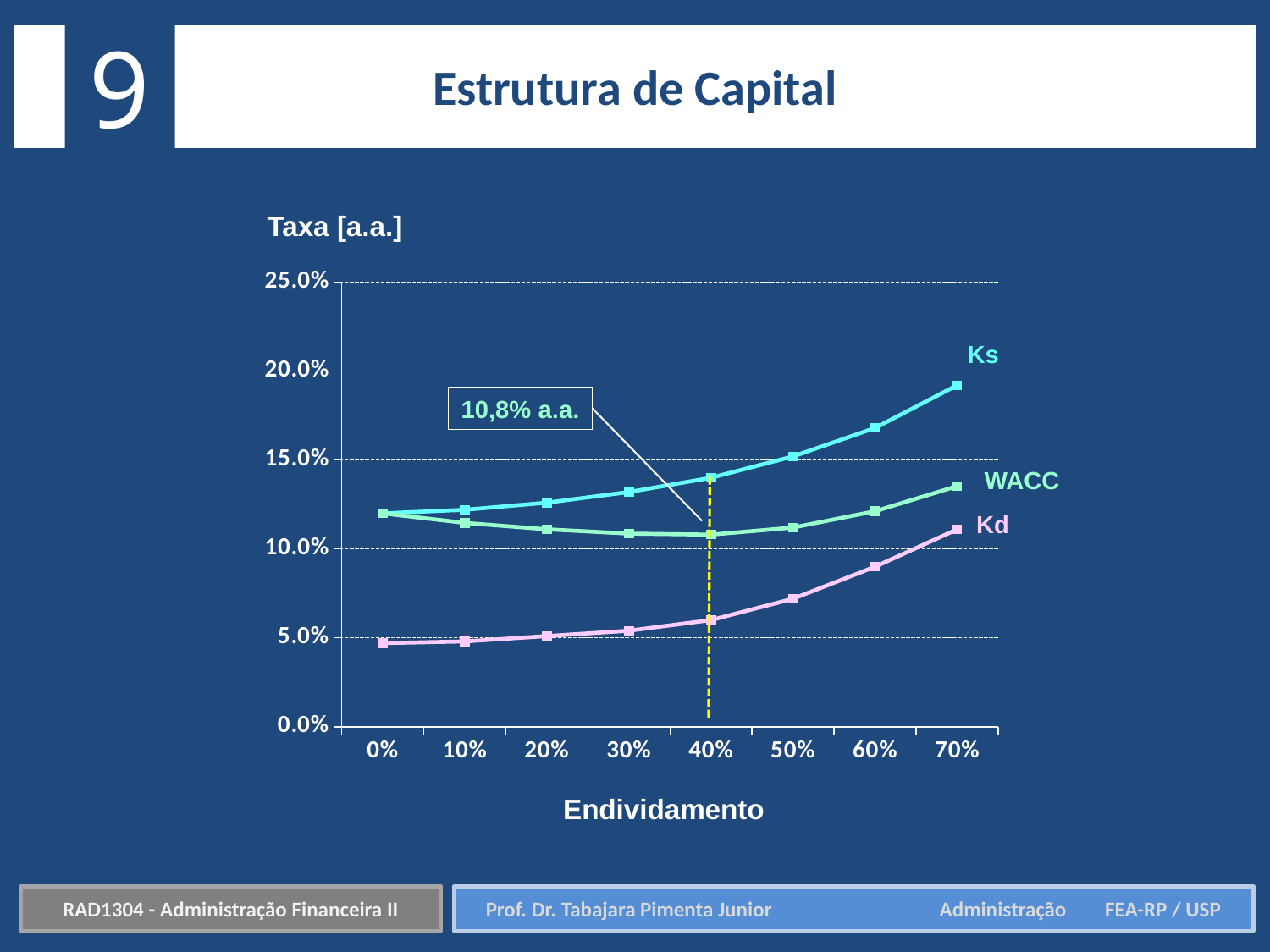
Is the value of Ks at 70% Endividamento greater or less than 15.0%? greater Does the Kd series rise or fall as Endividamento increases from 0% to 70%? rise Is the value of WACC at 70% Endividamento greater or less than 15.0%? less Is the value of Kd at 30% Endividamento greater or less than 10.0%? less What kind of chart is shown on the slide? line chart What is the title of the x axis? Endividamento How many series are plotted on the chart? 3 At 50% Endividamento, which is larger: Ks or Kd? Ks How many points along the x axis (Endividamento) does each series have? 8 At which level of Endividamento does the Ks series reach its highest value? 70% At which level of Endividamento does the WACC series reach its lowest value? 40% What is the labelled value of WACC at 40% Endividamento? 10,8% a.a.